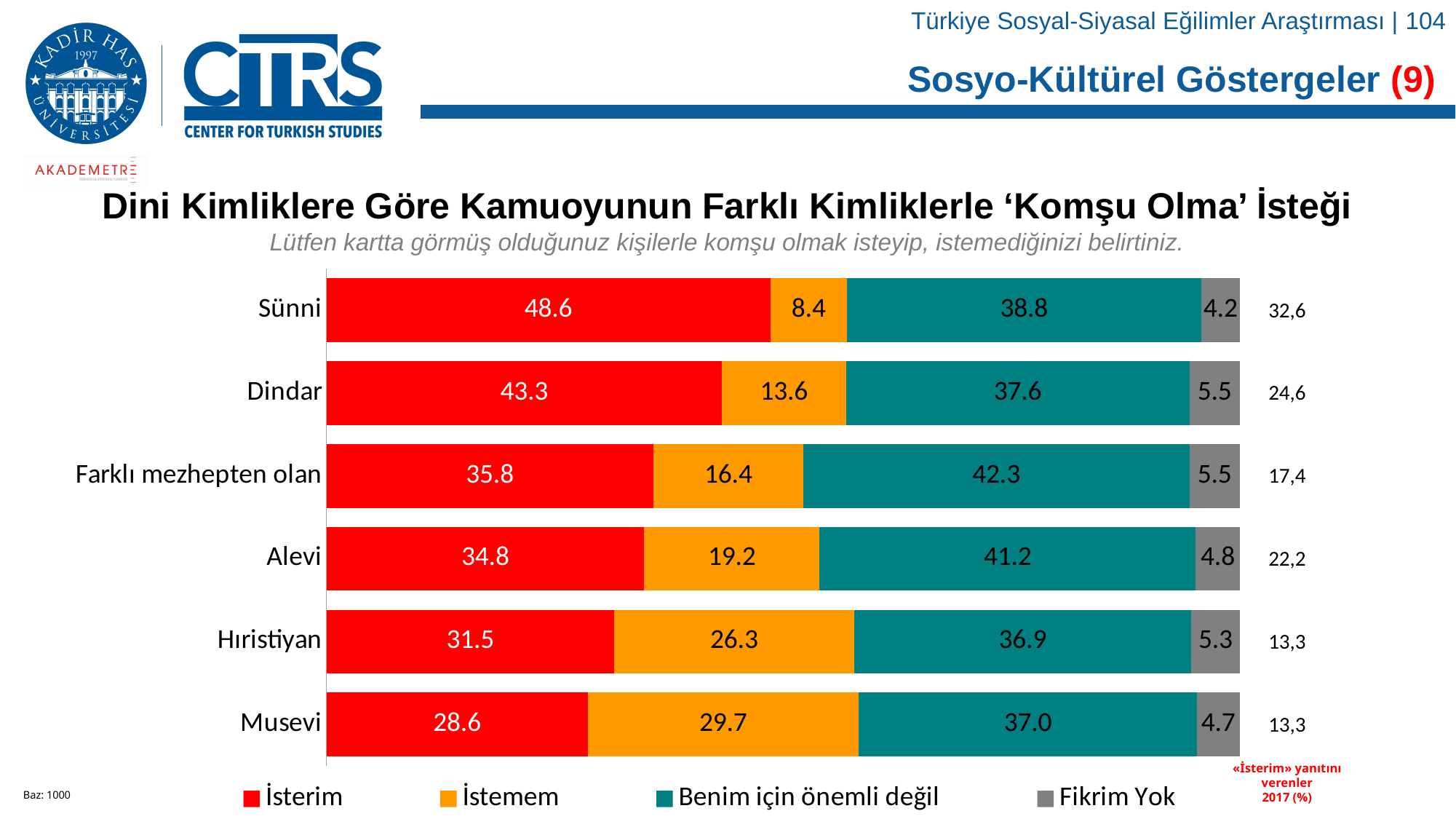
Which category has the highest 'İsterim' value? Sünni What is the 'Fikrim Yok' value for Dindar? 5.5 How many categories are shown on the chart? 6 How many series does the legend list? 4 What is the 'İsterim' value for Sünni? 48.6 What kind of chart is shown on the slide? Stacked bar chart What is the 'İstemem' value for Musevi? 29.7 Which category has the lowest 'İsterim' value? Musevi Which category has the highest 'İstemem' value? Musevi What is the difference between the 'İstemem' values for Hıristiyan and Sünni? 17.9 What is the 2017 'İsterim' percentage shown to the right of the Alevi bar? 22,2 Which has a larger 'Benim için önemli değil' value, Farklı mezhepten olan or Alevi? Farklı mezhepten olan